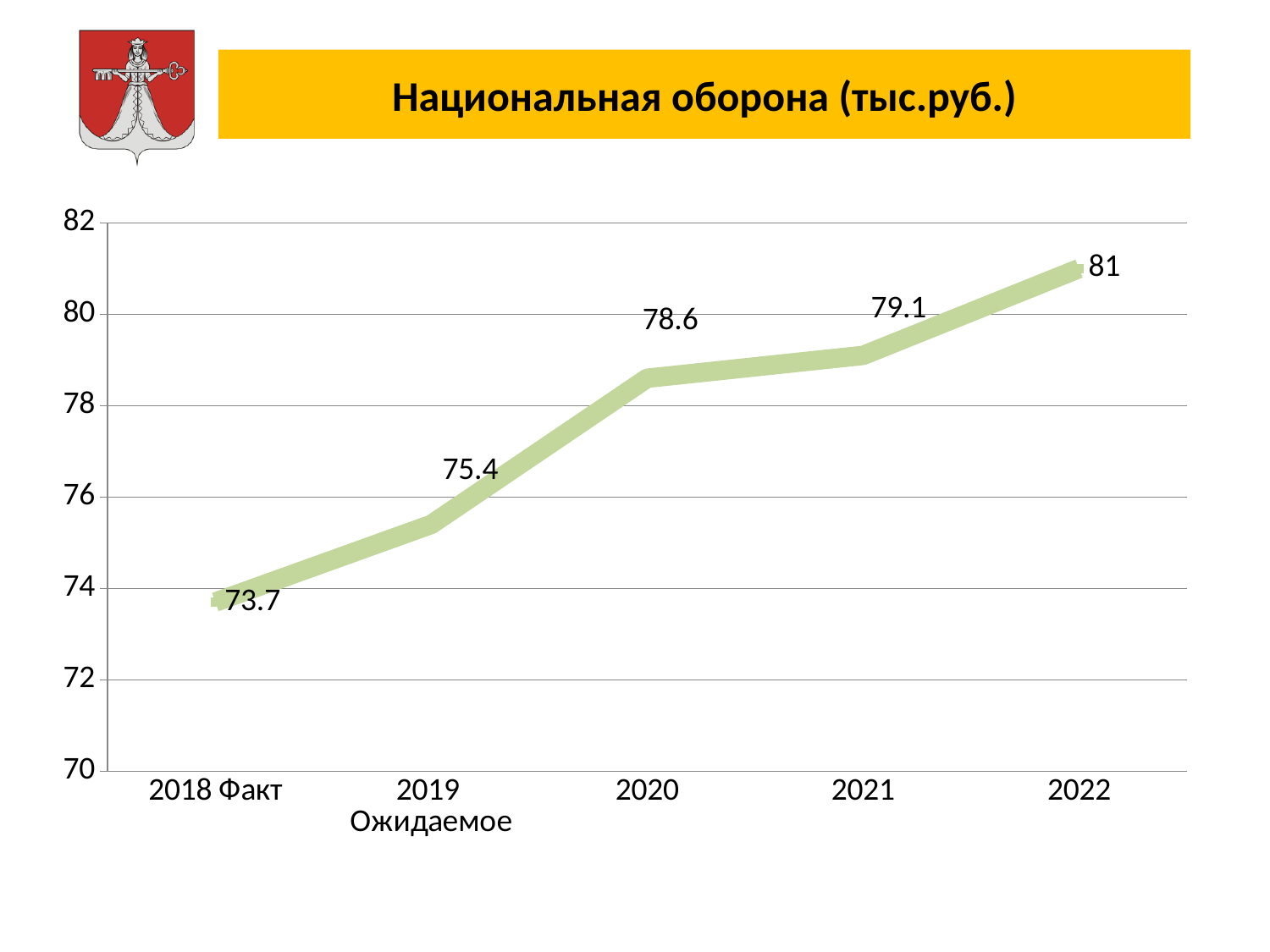
What is the value for 2019 Ожидаемое? 75.4 What is the value for 2018 Факт? 73.7 What is the value for 2020? 78.6 What is the difference between the values for 2022 and 2018 Факт? 7.3 Which is larger, the value for 2019 Ожидаемое or the value for 2021? 2021 What is the value for 2022? 81 What is the difference between the values for 2021 and 2020? 0.5 Which year has the highest value? 2022 Do the values rise or fall from 2018 to 2022? rise What kind of chart is shown on the slide? line chart How many data points are plotted on the chart? 5 Which category has the lowest value? 2018 Факт